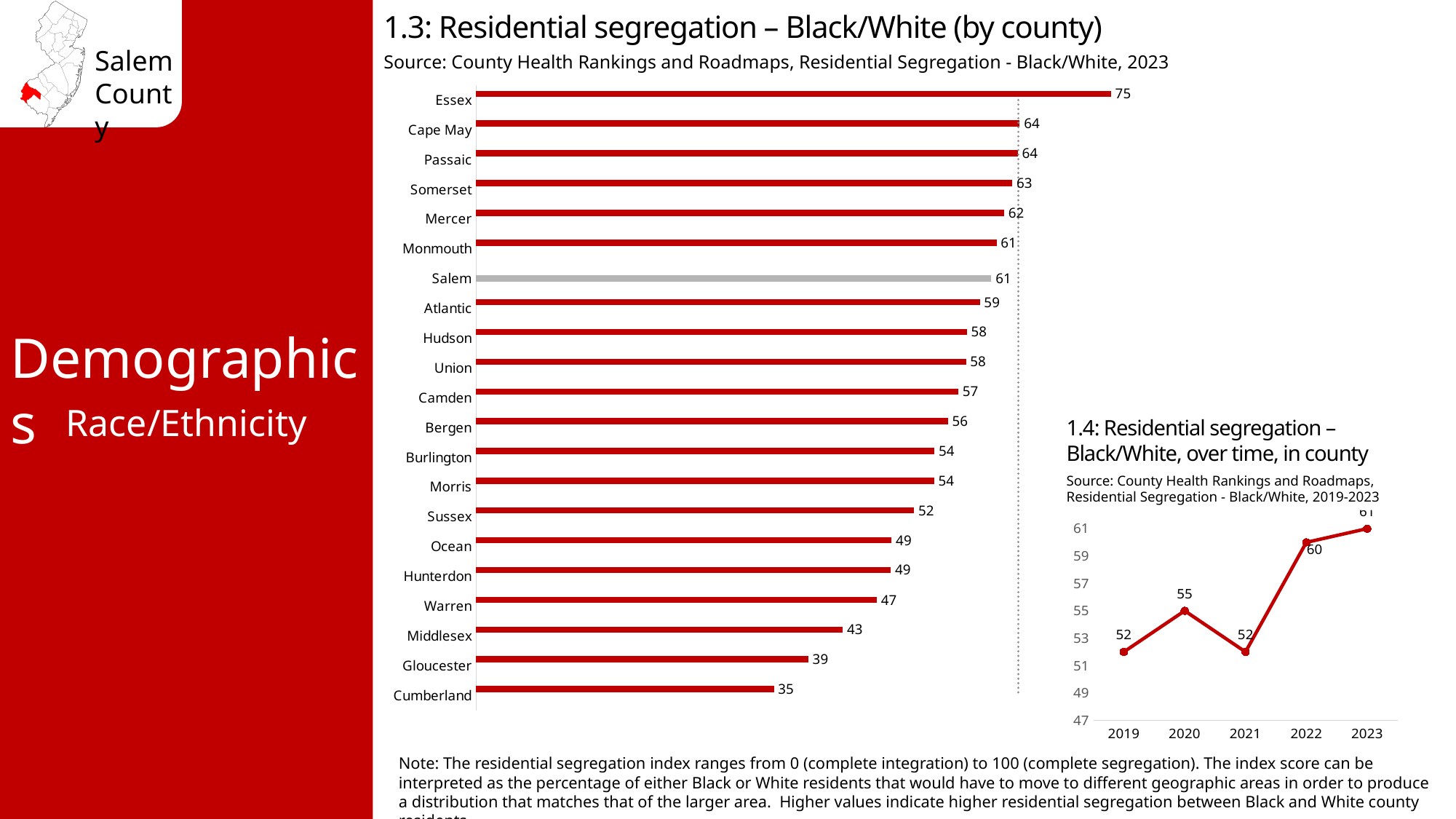
What kind of chart is '1.4: Residential segregation – Black/White, over time, in county'? line chart In the chart '1.3: Residential segregation – Black/White (by county)', what is the value for Cumberland? 35 In the chart '1.3: Residential segregation – Black/White (by county)', what is the value for Salem? 61 In the chart '1.4: Residential segregation – Black/White, over time, in county', is the value for 2023 greater or less than 59? greater In the chart '1.3: Residential segregation – Black/White (by county)', which county has the highest value? Essex In the chart '1.3: Residential segregation – Black/White (by county)', what is the difference between the values for Essex and Gloucester? 36 In the chart '1.3: Residential segregation – Black/White (by county)', which has a larger value, Middlesex or Warren? Warren In the chart '1.4: Residential segregation – Black/White, over time, in county', what is the difference between the values for 2022 and 2021? 8 What kind of chart is '1.3: Residential segregation – Black/White (by county)'? bar chart In the chart '1.4: Residential segregation – Black/White, over time, in county', what is the value for 2020? 55 In the chart '1.3: Residential segregation – Black/White (by county)', which county has the lowest value? Cumberland How many counties are shown in the chart '1.3: Residential segregation – Black/White (by county)'? 21